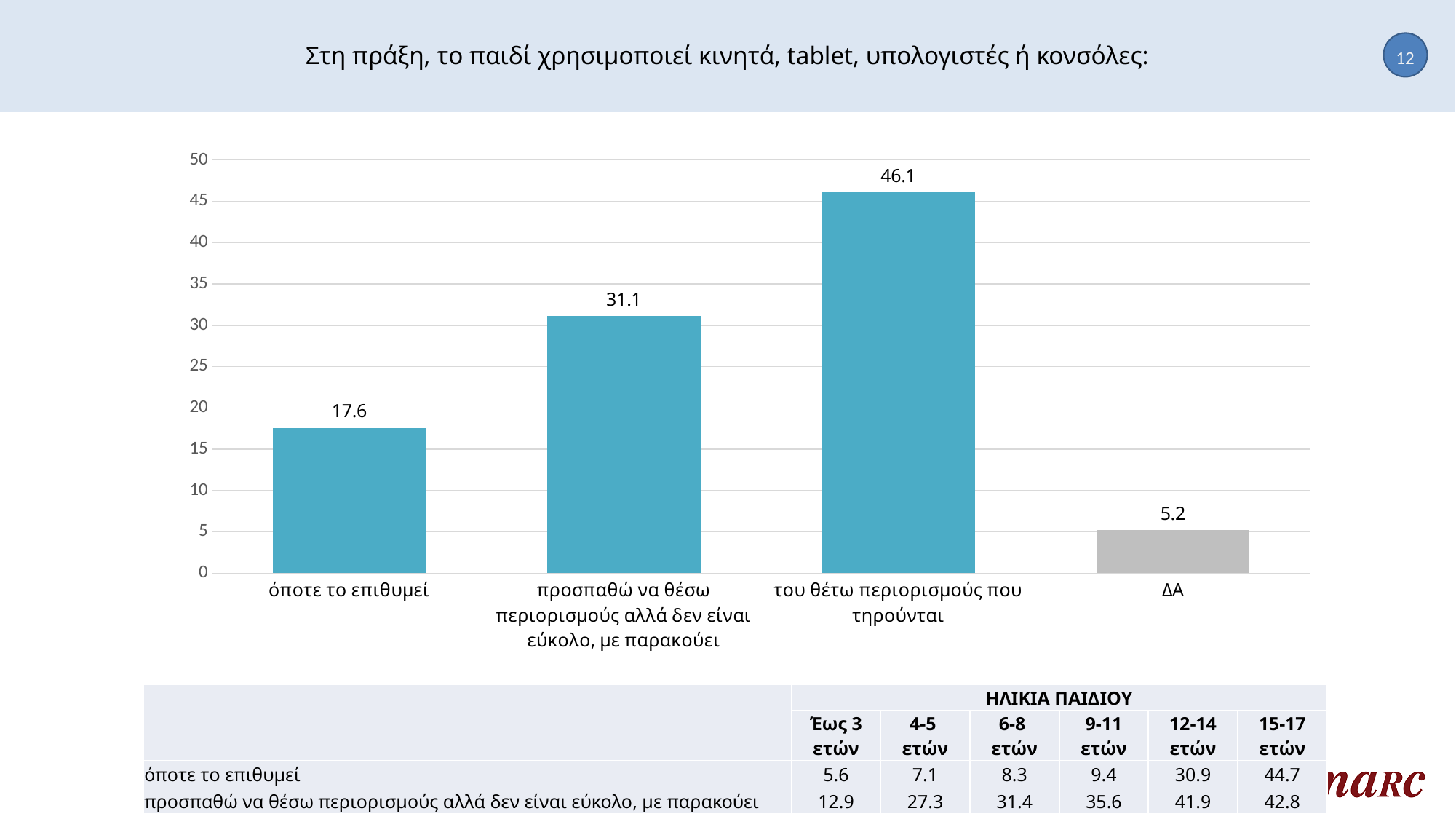
Which category has the lowest value? ΔΑ What is the difference between the values for "του θέτω περιορισμούς που τηρούνται" and "όποτε το επιθυμεί"? 28.5 Is the value for "του θέτω περιορισμούς που τηρούνται" greater or less than 40? greater What is the value for "ΔΑ"? 5.2 Which is larger, the value for "όποτε το επιθυμεί" or the value for "προσπαθώ να θέσω περιορισμούς αλλά δεν είναι εύκολο, με παρακούει"? προσπαθώ να θέσω περιορισμούς αλλά δεν είναι εύκολο, με παρακούει How many categories are shown in the chart? 4 What is the difference between the values for "προσπαθώ να θέσω περιορισμούς αλλά δεν είναι εύκολο, με παρακούει" and "ΔΑ"? 25.9 What is the value for "προσπαθώ να θέσω περιορισμούς αλλά δεν είναι εύκολο, με παρακούει"? 31.1 Which category has the highest value? του θέτω περιορισμούς που τηρούνται What is the value for "του θέτω περιορισμούς που τηρούνται"? 46.1 What is the value for "όποτε το επιθυμεί"? 17.6 What kind of chart is shown on the slide? bar chart